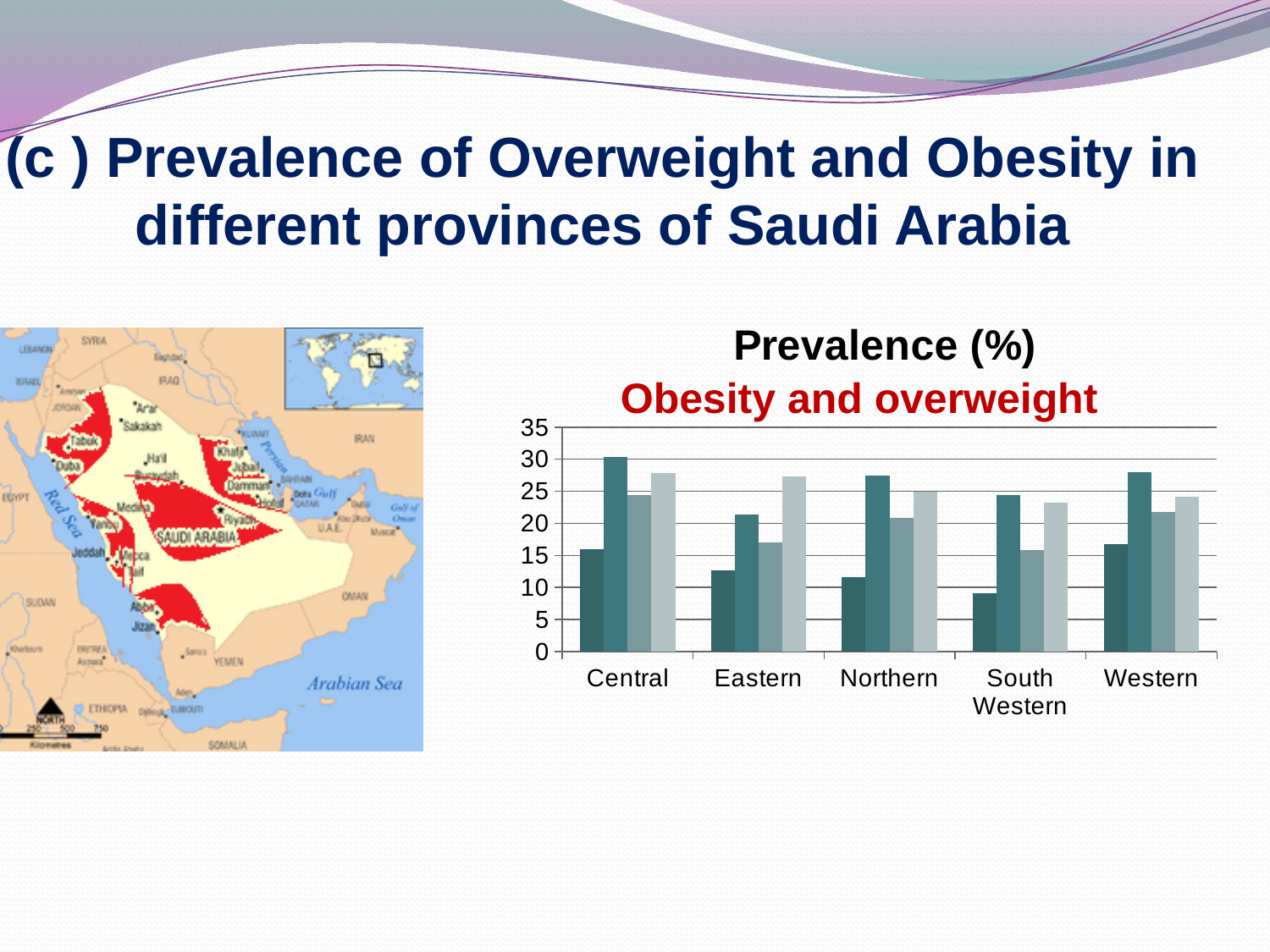
Is the value of the first (darkest) bar for Eastern greater or less than 15? less How many provinces are shown on the x axis of the chart? 5 Is the value of the first (darkest) bar for Central greater or less than 20? less Is the value of the second bar for Western greater or less than 25? greater Which province has the shortest bar in the chart? South Western What kind of chart is shown on the slide? bar chart What is the red subtitle shown above the chart? Obesity and overweight How many bars are plotted for each province in the chart? 4 Which province has the tallest bar in the chart? Central Which is larger: the first (darkest) bar for Central or the first (darkest) bar for South Western? Central